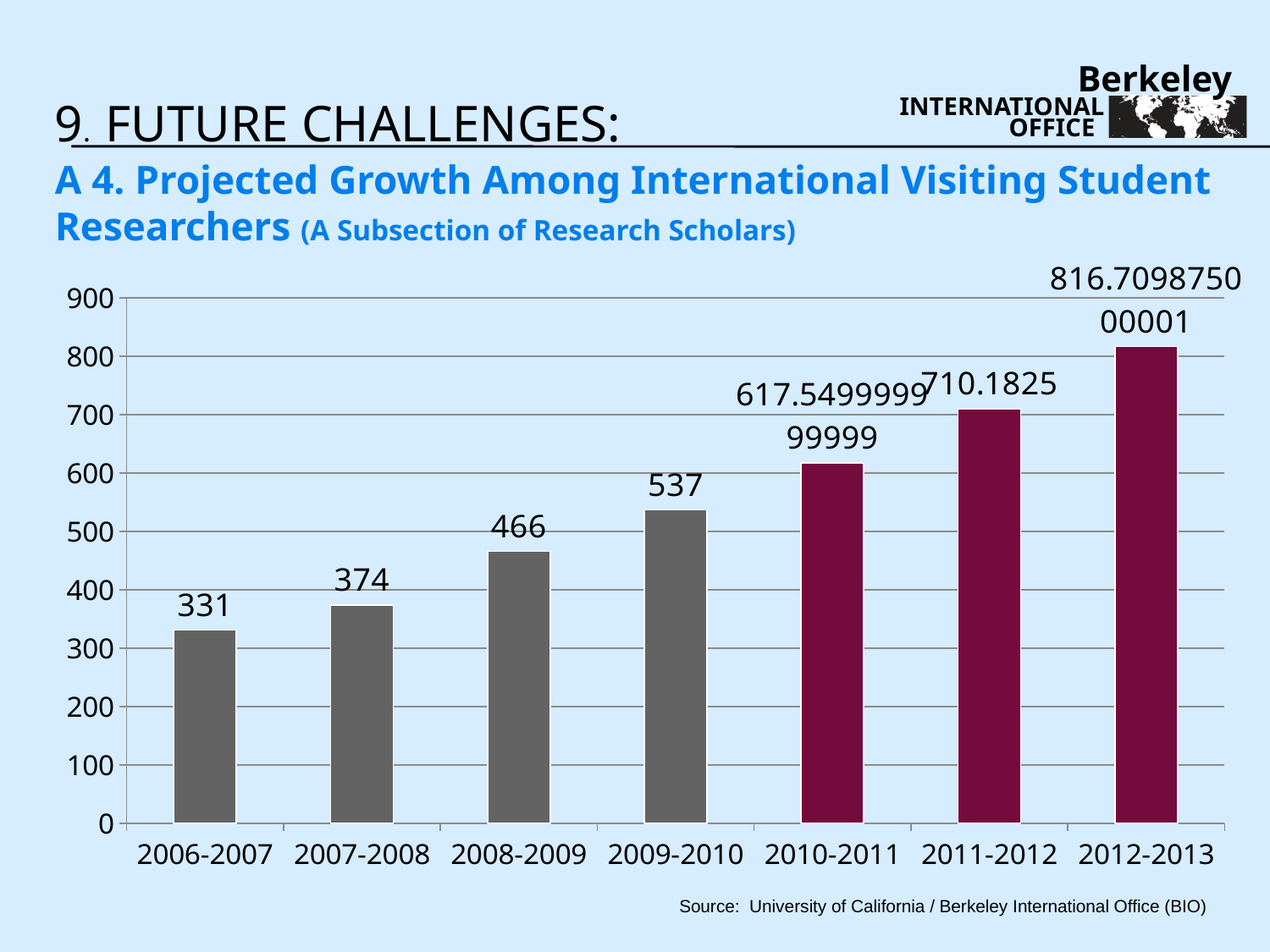
How many academic years (categories) are shown on the x axis? 7 Which is larger, the value for 2007-2008 or the value for 2008-2009? 2008-2009 What kind of chart is shown on the slide? bar chart Which year has the lowest value? 2006-2007 Do the values rise or fall from 2006-2007 to 2012-2013? rise What is the value for 2006-2007? 331 Which year has the highest value? 2012-2013 What is the value for 2009-2010? 537 What is the value for 2008-2009? 466 What is the value for 2011-2012? 710.1825 What is the difference between the values for 2009-2010 and 2006-2007? 206 Is the value for 2010-2011 greater or less than 600? greater